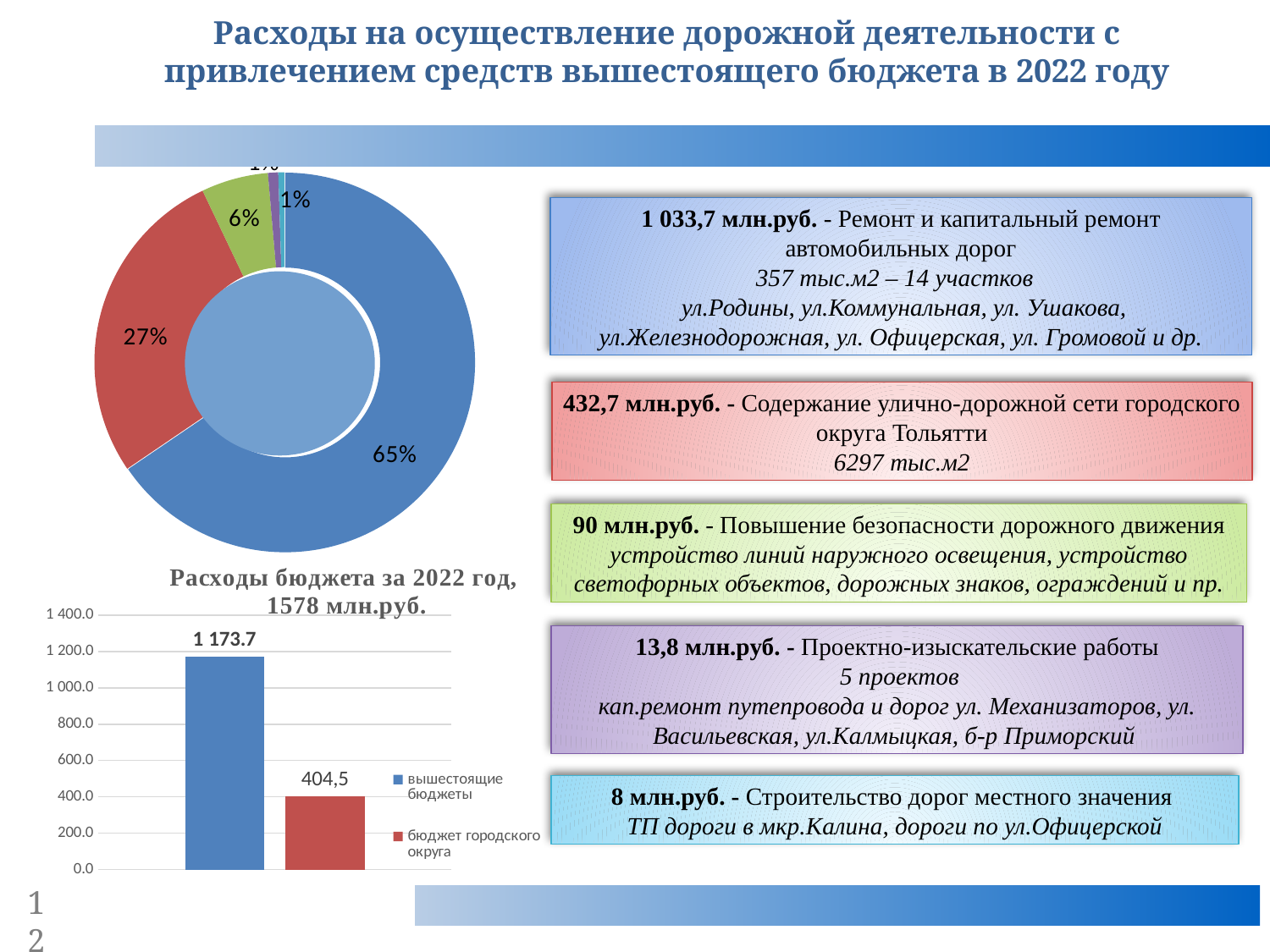
In the bar chart 'Расходы бюджета за 2022 год', what is the value for 'бюджет городского округа'? 404,5 In the bar chart 'Расходы бюджета за 2022 год', what is the difference between the values for 'вышестоящие бюджеты' and 'бюджет городского округа'? 769.2 In the bar chart 'Расходы бюджета за 2022 год', which series has the lower value? бюджет городского округа In the bar chart 'Расходы бюджета за 2022 год', is the value for 'бюджет городского округа' greater or less than 600.0? less In the bar chart 'Расходы бюджета за 2022 год', is the value for 'вышестоящие бюджеты' greater or less than 1 000.0? greater In the doughnut chart at the top left of the slide, what is the share of the largest slice? 65% What kind of chart is the chart at the top left of the slide? doughnut chart What kind of chart is the chart at the bottom left of the slide? bar chart What is the title of the bar chart at the bottom left of the slide? Расходы бюджета за 2022 год, 1578 млн.руб. In the bar chart 'Расходы бюджета за 2022 год', which series has the higher value? вышестоящие бюджеты In the bar chart 'Расходы бюджета за 2022 год', what is the value for 'вышестоящие бюджеты'? 1 173.7 How many series does the legend of the bar chart 'Расходы бюджета за 2022 год' list? 2